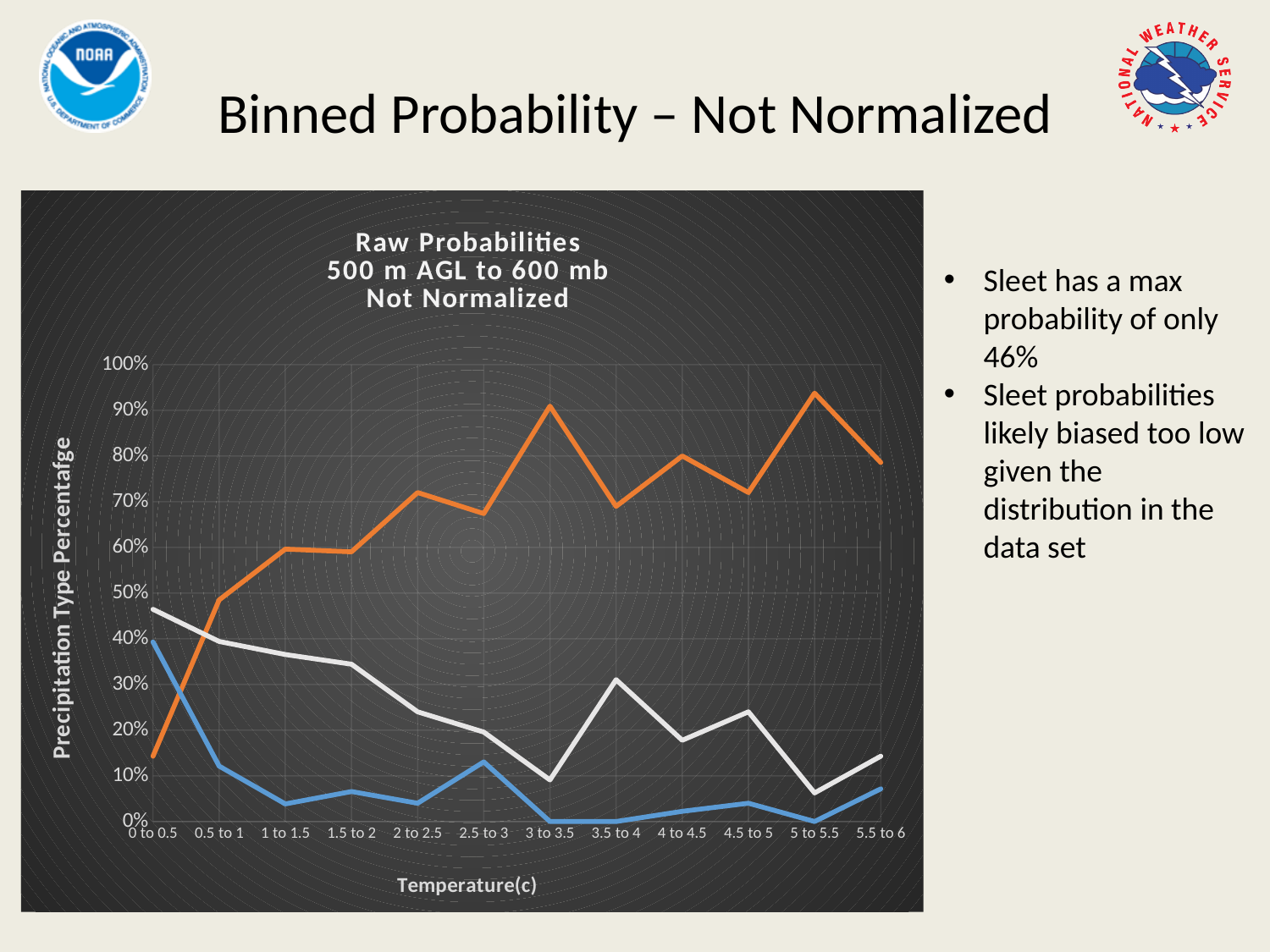
What kind of chart is shown on the slide? line chart Is the value of the orange line at 0 to 0.5 greater or less than 20%? less At which temperature bin does the white line reach its highest value? 0 to 0.5 Is the value of the blue line at 3 to 3.5 greater or less than 10%? less What is the label of the x axis of the chart? Temperature(c) Is the value of the orange line at 3 to 3.5 greater or less than 80%? greater How many temperature bins are shown along the x axis of the chart? 12 At 0 to 0.5, which line has the larger value, the white line or the orange line? white line What is the title of the chart? Raw Probabilities 500 m AGL to 600 mb Not Normalized Does the orange line generally rise or fall as temperature increases along the x axis? rise At which temperature bin does the orange line have its lowest value? 0 to 0.5